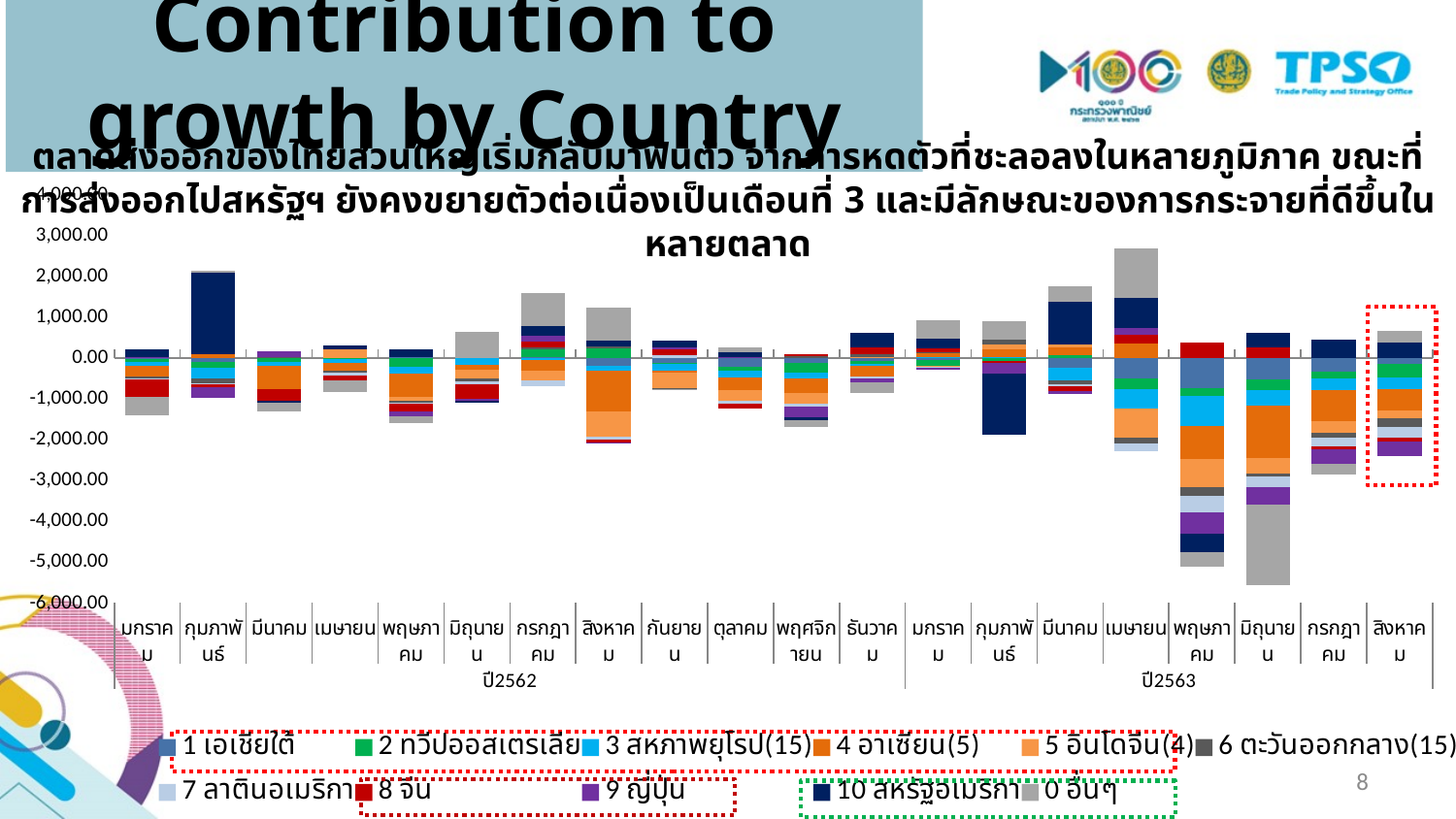
Is the top of the stacked bar for มีนาคม ปี2563 greater or less than 1,000.00? greater How many monthly bars are plotted on the chart in total? 20 What kind of chart is shown on the slide? Stacked bar chart Is the top of the stacked bar for เมษายน ปี2563 greater or less than 2,000.00? greater Which month's stacked bar reaches the highest positive value on the chart? เมษายน ปี2563 What is the title of the chart? Contribution to growth by Country Is the lowest point of the stacked bar for กุมภาพันธ์ ปี2563 greater or less than -1,000.00? less Which legend entry is shown in dark navy blue? 10 สหรัฐอเมริกา How many series does the chart legend list? 11 Which month's stacked bar extends to the lowest negative value on the chart? มิถุนายน ปี2563 How many months are plotted for ปี2563? 8